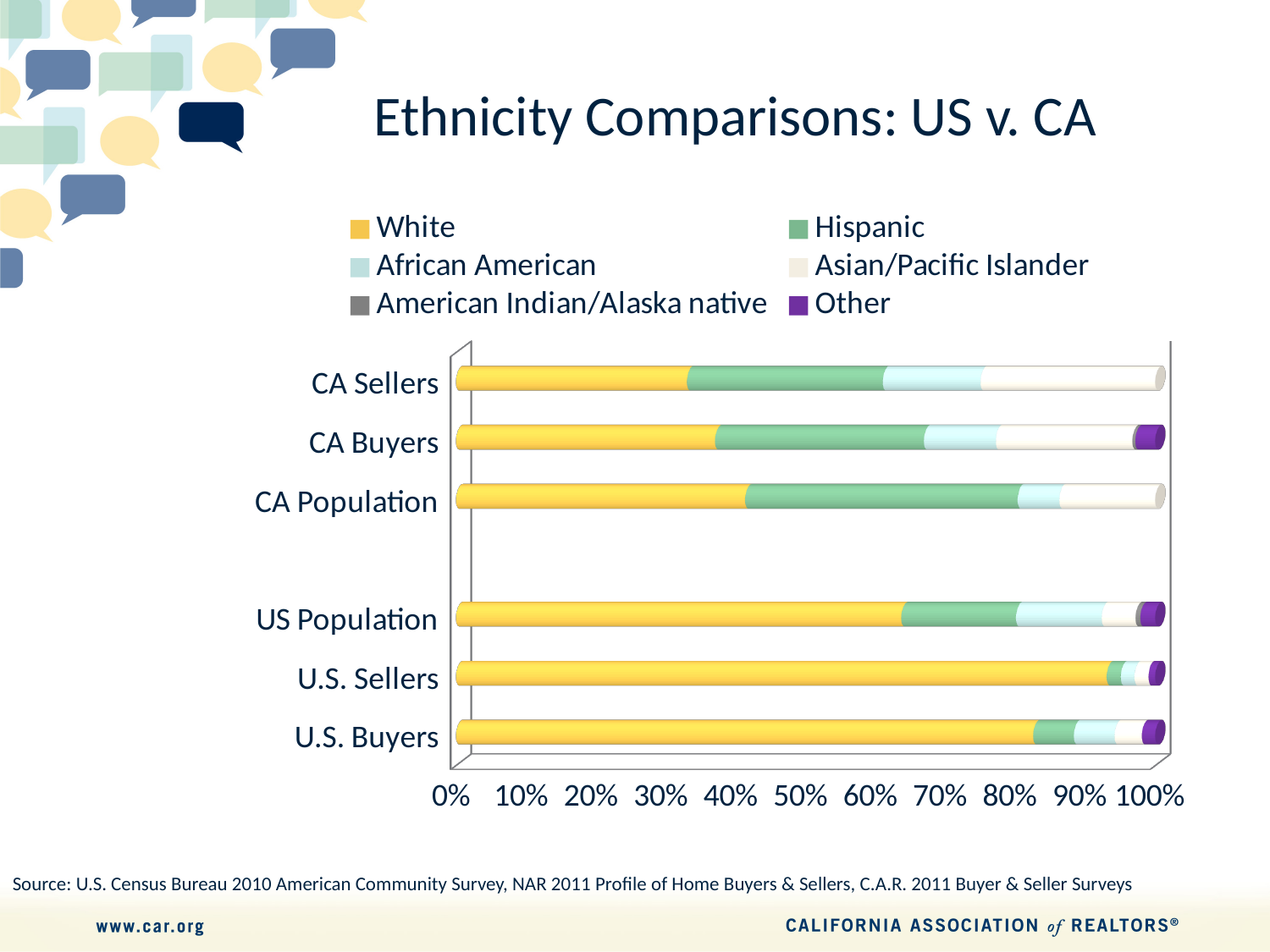
Which category has the largest Hispanic segment? CA Population Is the White share for US Population greater or less than 60%? greater Is the White share for CA Population greater or less than 50%? less How many series does the chart's legend list? 6 What kind of chart is shown on the slide? bar chart What is the title of the chart on the slide? Ethnicity Comparisons: US v. CA How many categories are plotted on the y axis of the chart? 6 Which colour represents the White series in the chart? yellow Is the White share for U.S. Sellers greater or less than 90%? greater Which category has the largest White segment? U.S. Sellers